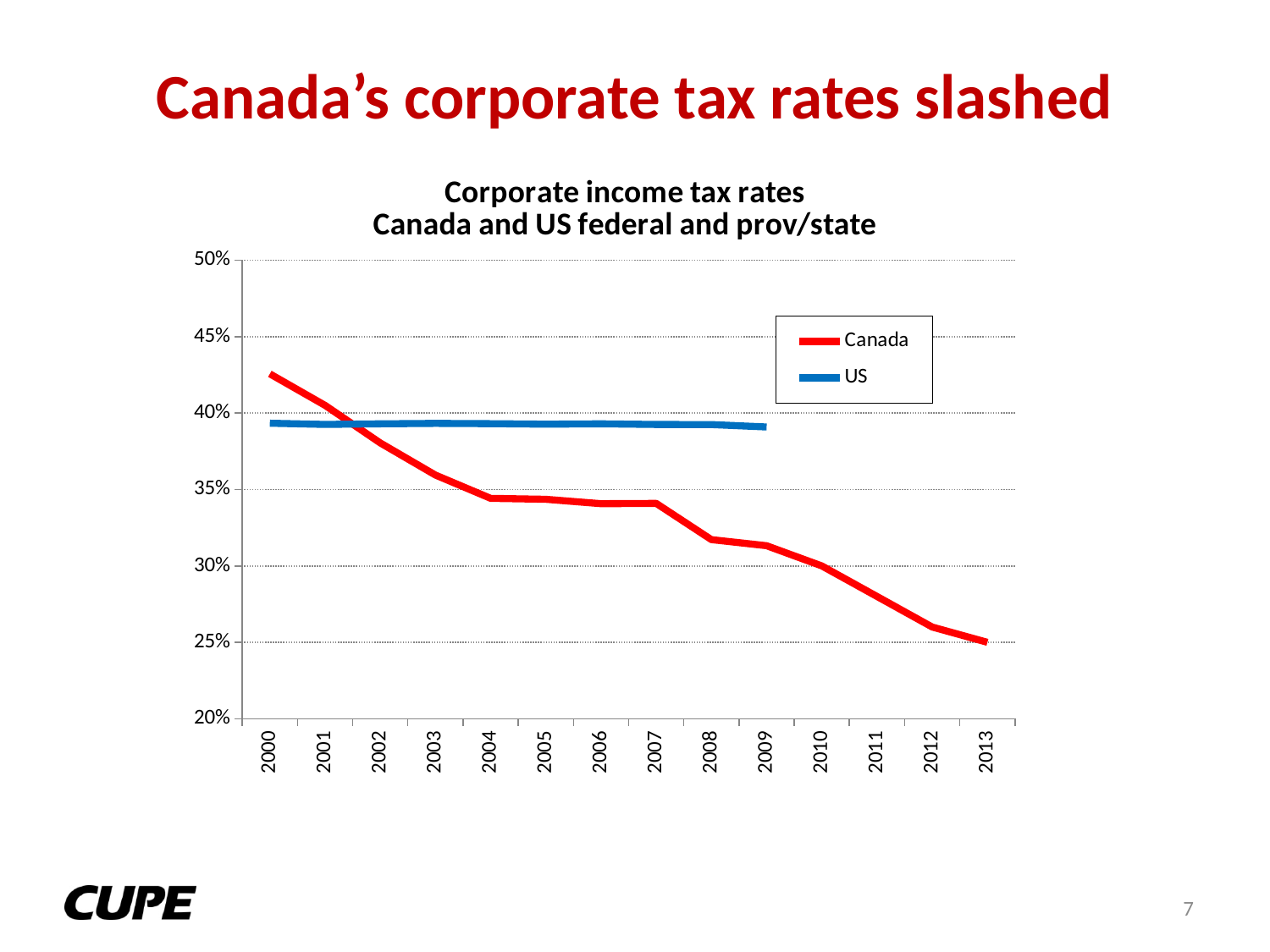
What kind of chart is shown on the slide? line chart In 2009, which series has the higher rate, Canada or US? US Is the Canada rate in 2000 greater or less than 40%? greater What colour is the Canada line? red In which year is the Canada corporate tax rate lowest? 2013 Does the Canada line rise or fall from 2000 to 2013? fall Is the Canada rate in 2013 greater or less than 30%? less How many series does the legend list? 2 In which year is the Canada corporate tax rate highest? 2000 Is the Canada rate in 2008 greater or less than 35%? less How many years are labelled on the x axis? 14